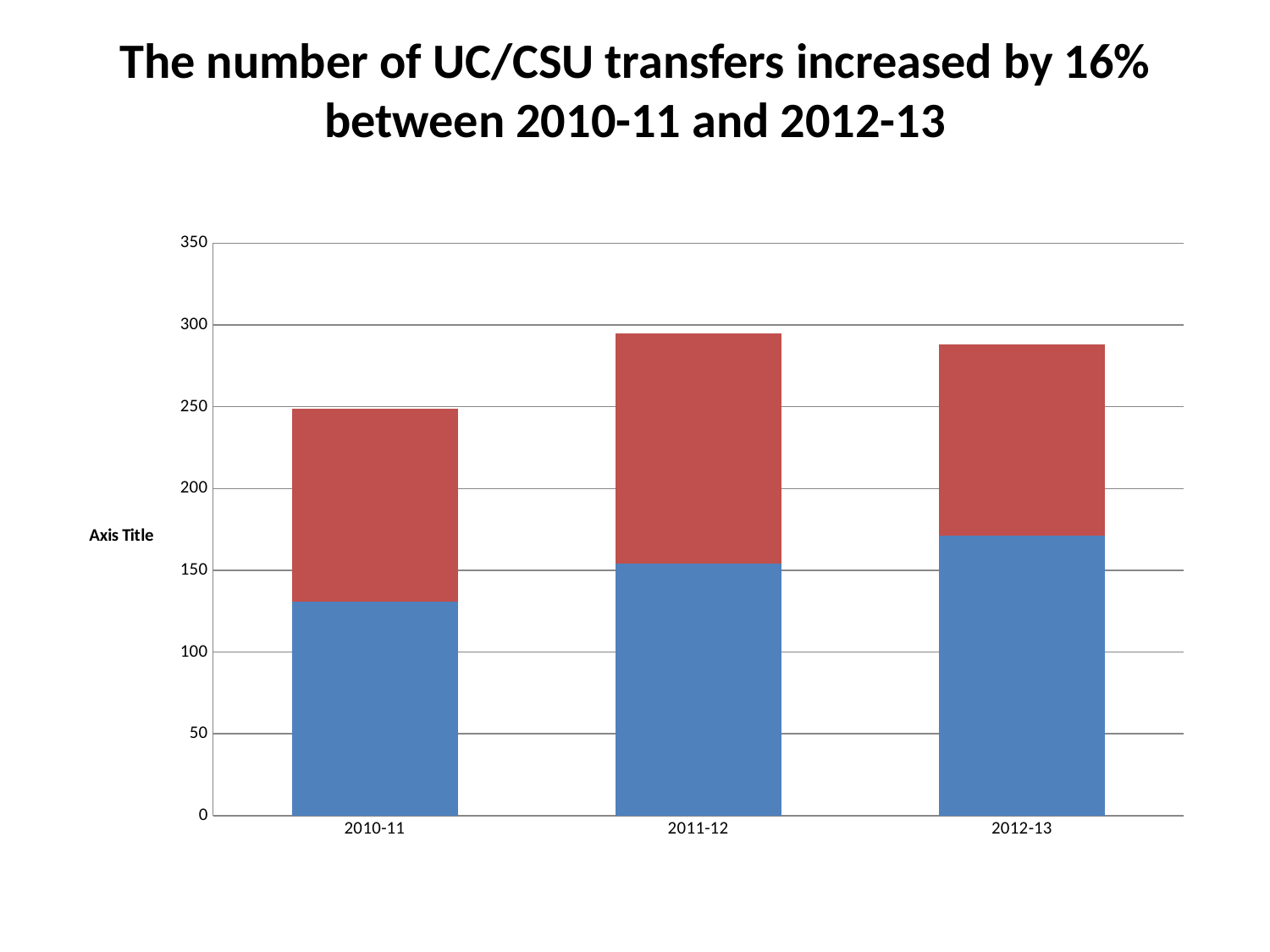
Is the total bar height for 2011-12 greater or less than 250? greater Which academic year has the tallest blue segment in the chart? 2012-13 Is the total bar height for 2011-12 greater or less than 300? less Is the total bar for 2011-12 taller or shorter than the total bar for 2010-11? taller Which academic year has the lowest total bar height in the chart? 2010-11 Is the total bar height for 2010-11 greater or less than 200? greater Which academic year has the shortest blue segment in the chart? 2010-11 What text is shown as the vertical axis title of the chart? Axis Title How many academic years are shown on the x axis of the chart? 3 What kind of chart is shown on the slide? stacked bar chart